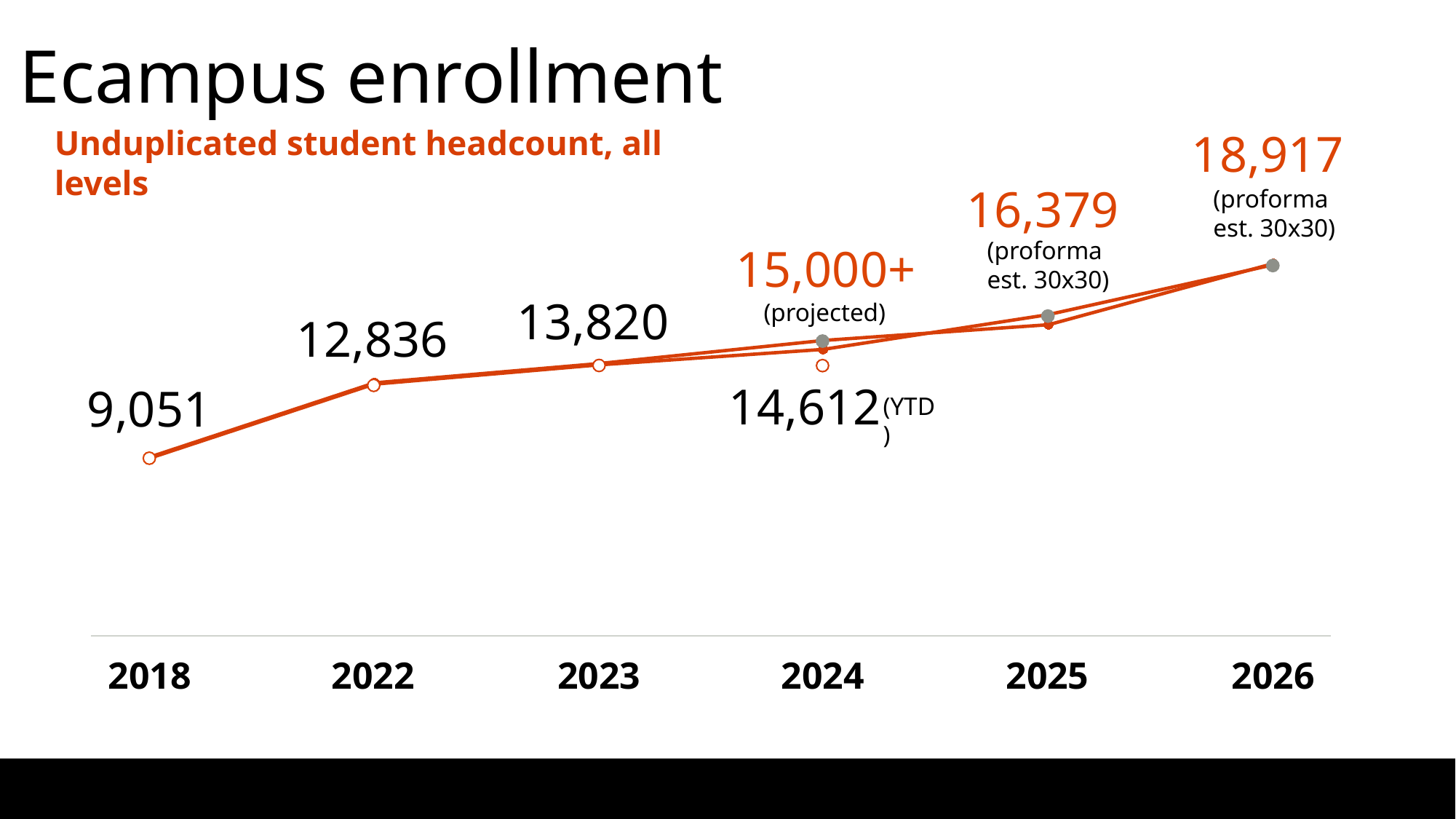
Which year has the lowest value on the chart? 2018 What is the enrollment value shown for 2018? 9,051 What is the enrollment value shown for 2023? 13,820 Which year has the larger value, 2022 or 2023? 2023 What is the difference between the 2022 value and the 2018 value? 3,785 What is the enrollment value shown for 2022? 12,836 What is the difference between the 2026 proforma estimate and the 2025 proforma estimate? 2,538 Which year has the highest value on the chart? 2026 How many years are shown on the x axis of the chart? 6 What kind of chart is shown on the slide? Line chart What is the proforma estimate shown for 2026? 18,917 What is the year-to-date (YTD) enrollment value shown for 2024? 14,612